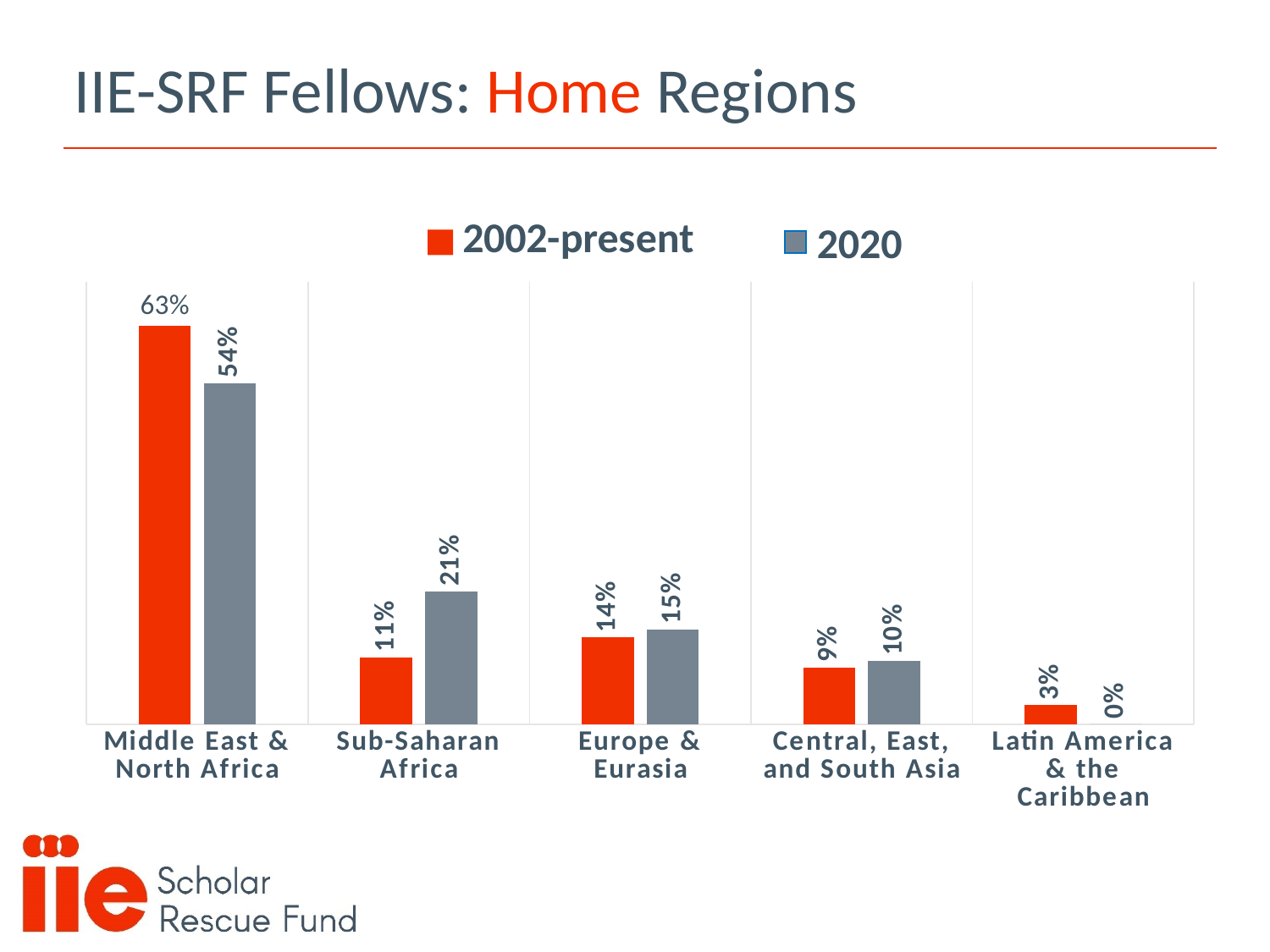
What is the 2020 value for Sub-Saharan Africa? 21% Which region has the highest 2020 value? Middle East & North Africa What is the difference between the 2020 and 2002-present values for Sub-Saharan Africa? 10% What is the 2002-present value for Middle East & North Africa? 63% What is the 2020 value for Latin America & the Caribbean? 0% What is the difference between the 2002-present and 2020 values for Middle East & North Africa? 9% How many regions are shown on the x axis? 5 What is the 2002-present value for Central, East, and South Asia? 9% Which is larger for Europe & Eurasia: the 2002-present value or the 2020 value? 2020 Which region has the lowest 2002-present value? Latin America & the Caribbean What kind of chart is shown on the slide? Bar chart How many series does the legend list? 2